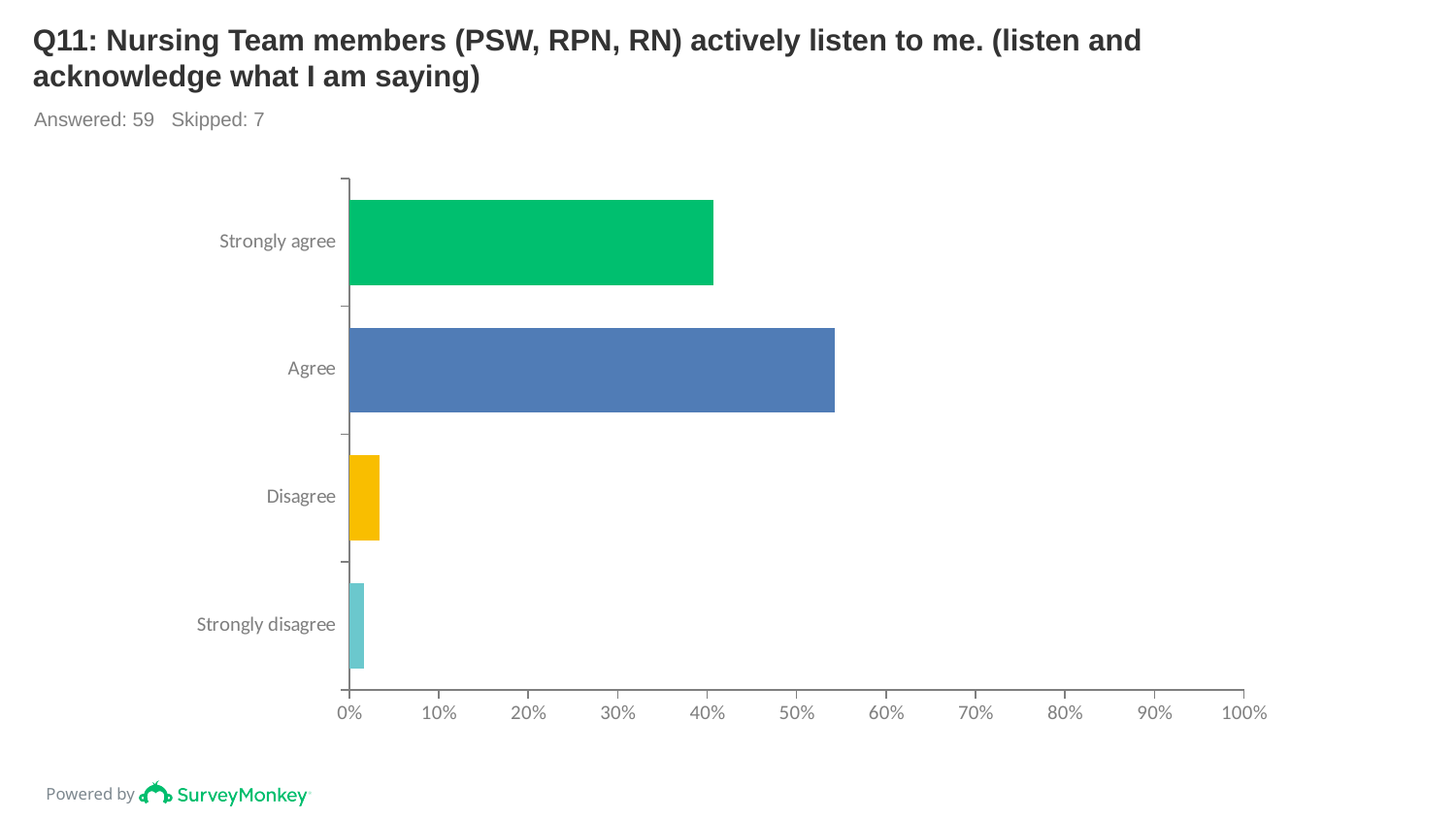
Is the value for Disagree greater or less than 10%? less Which response category has the highest value? Agree What is the maximum value shown on the horizontal axis? 100% Which is larger, the value for Agree or the value for Strongly agree? Agree Which response category has the lowest value? Strongly disagree How many response categories are shown in the chart? 4 Which is larger, the value for Disagree or the value for Strongly disagree? Disagree Is the value for Strongly agree greater or less than 30%? greater What kind of chart is shown on the slide? bar chart Is the value for Strongly agree greater or less than 50%? less How many respondents answered this question according to the slide? 59